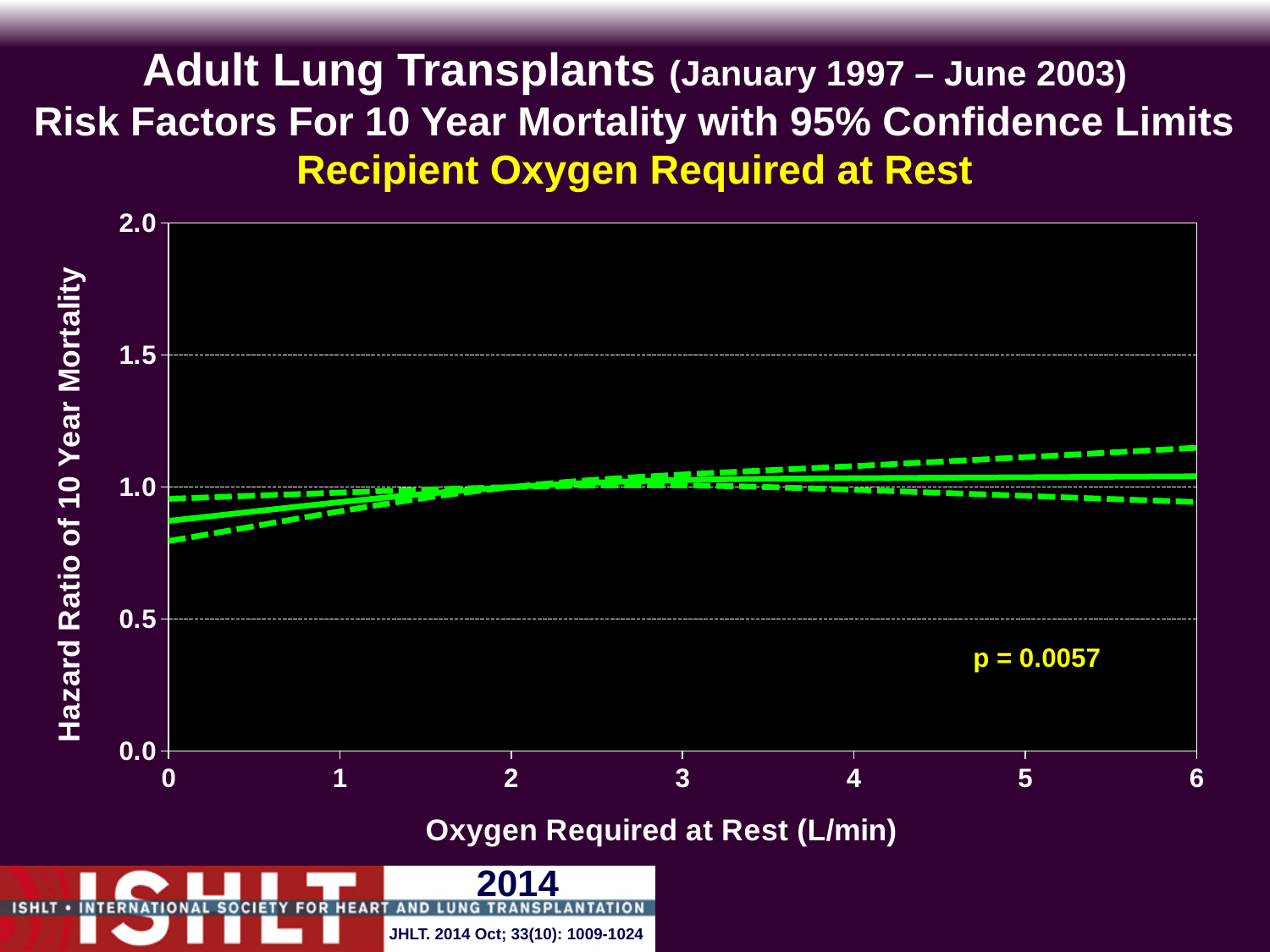
Is the upper 95% confidence limit at 6 L/min greater or less than 1.0? greater What p-value is printed on the chart? p = 0.0057 Which is larger, the hazard ratio at 0 L/min or the hazard ratio at 6 L/min? 6 L/min What kind of chart is shown on the slide? line chart Is the lower 95% confidence limit at 0 L/min greater or less than 1.0? less Is the hazard ratio at 0 L/min greater or less than 0.5? greater Does the hazard ratio of 10 year mortality rise or fall as oxygen required at rest increases from 0 to 6 L/min? rise What is the title of the x axis? Oxygen Required at Rest (L/min) What is the maximum value shown on the y axis? 2.0